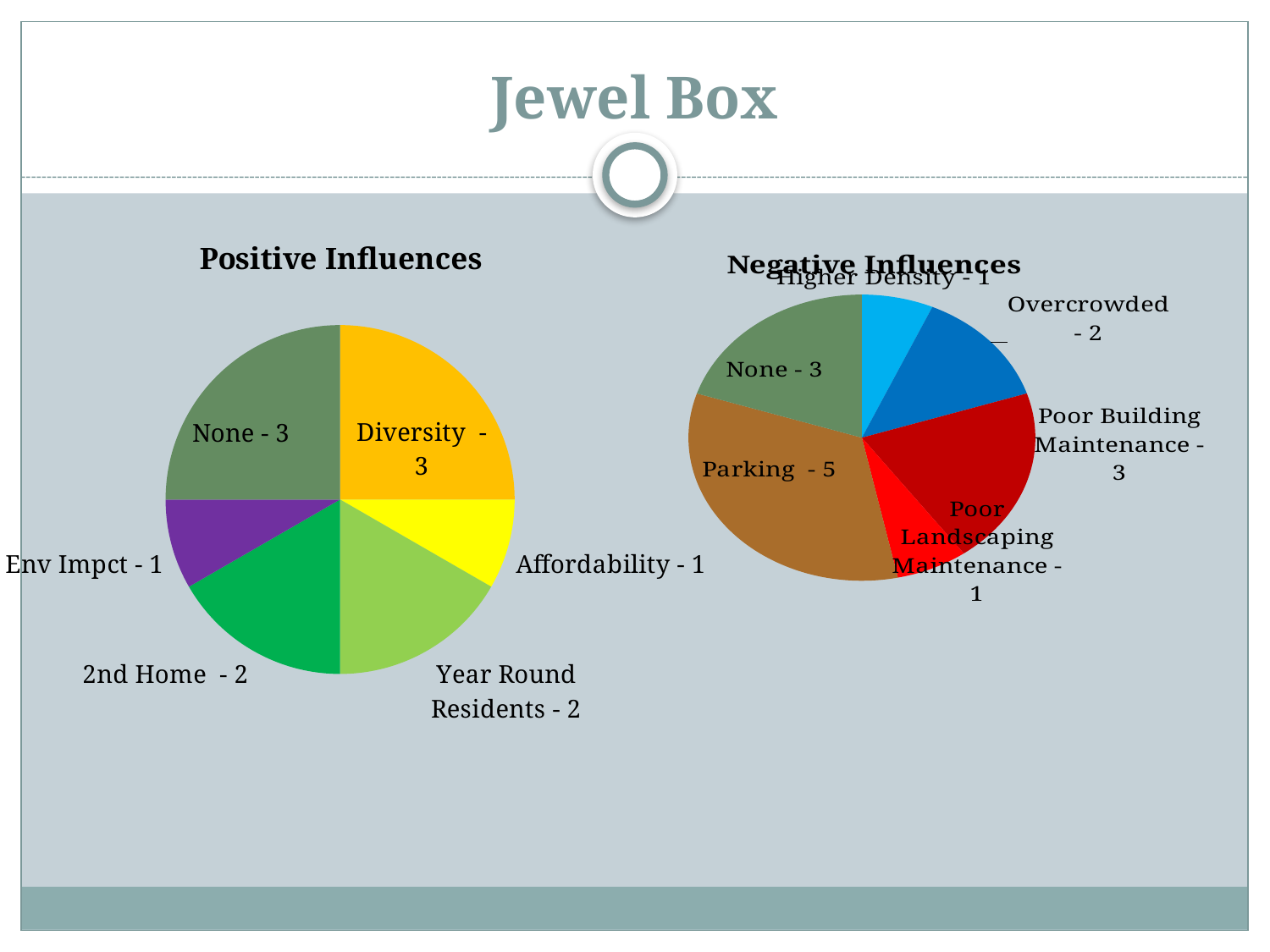
In the Negative Influences chart, which category has the largest slice? Parking In the Negative Influences chart, what is the difference between the values for Parking and Overcrowded? 3 In the Positive Influences chart, what value is shown for Year Round Residents? 2 How many categories are shown in the Positive Influences chart? 6 What is the title of the chart on the left side of the slide? Positive Influences In the Negative Influences chart, what value is shown for Parking? 5 What kind of chart is the Negative Influences chart? Pie chart In the Positive Influences chart, what share of the total does Diversity represent? 25% In the Positive Influences chart, which is larger, the value for 2nd Home or the value for Env Impct? 2nd Home How many categories are shown in the Negative Influences chart? 6 In the Negative Influences chart, what value is shown for Poor Building Maintenance? 3 In the Positive Influences chart, what value is shown for Diversity? 3